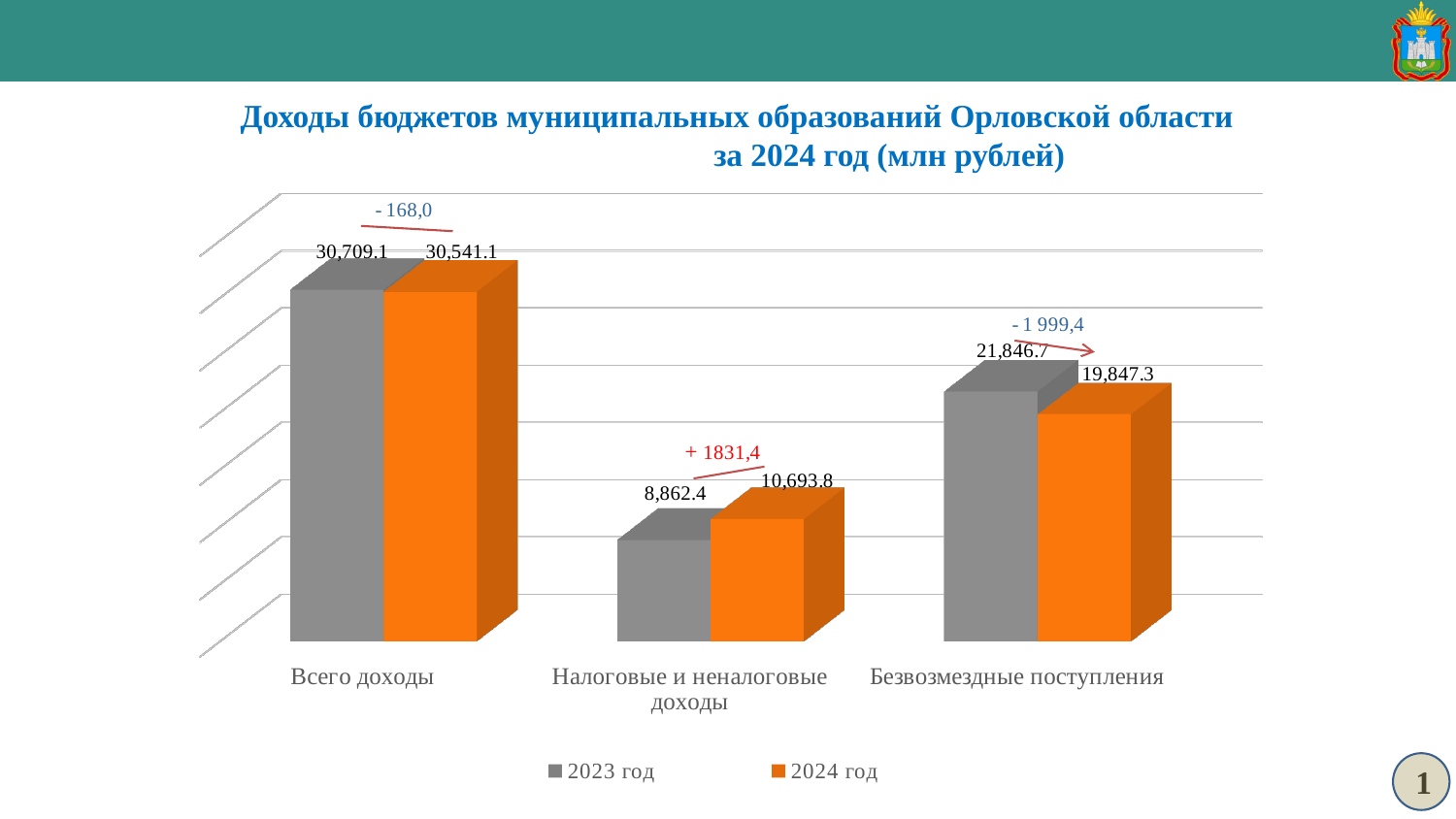
Which category has the lowest value for 2023 год? Налоговые и неналоговые доходы What colour represents the 2024 год series? Orange What is the value for 2023 год for Налоговые и неналоговые доходы? 8,862.4 How many categories are shown on the x axis? 3 How many series does the legend list? 2 What is the value for 2024 год for Всего доходы? 30,541.1 What is the value for 2023 год for Всего доходы? 30,709.1 What is the value for 2024 год for Безвозмездные поступления? 19,847.3 What kind of chart is shown on the slide? Bar chart What is the difference between the 2024 год and 2023 год values for Налоговые и неналоговые доходы? 1,831.4 For Безвозмездные поступления, which is larger: the 2023 год value or the 2024 год value? 2023 год Which category has the highest value for 2024 год? Всего доходы